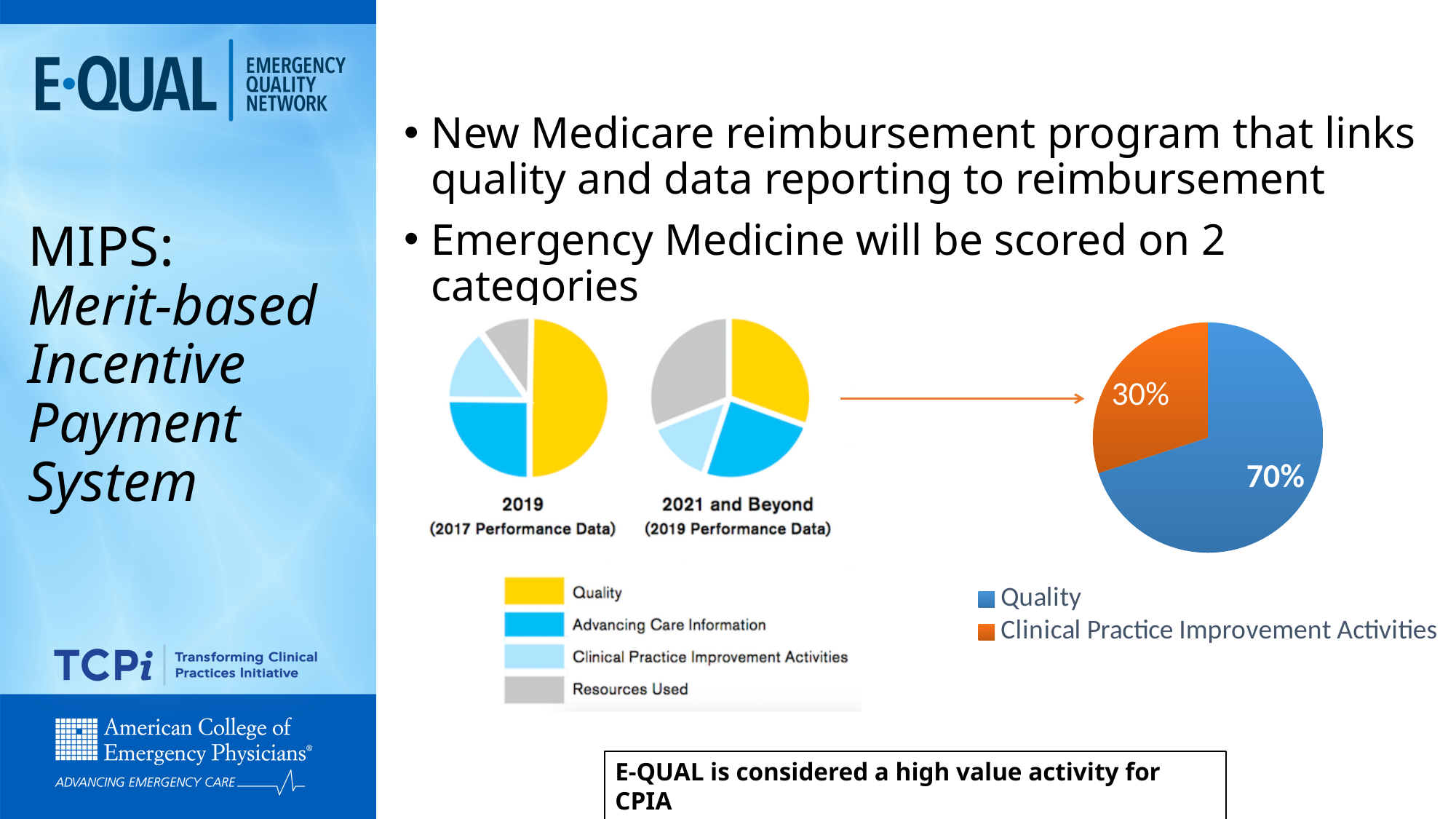
In the 2019 (2017 Performance Data) pie chart, which category has the largest slice? Quality In the pie chart on the right of the slide, which category has the larger share? Quality What kind of chart is shown on the right of the slide with the 70% and 30% labels? Pie chart How many categories does the legend of the pie chart on the right of the slide list? 2 In the pie chart on the right of the slide, what share is labelled for Quality? 70% How many categories does the legend for the 2019 and 2021 and Beyond pie charts list? 4 In the pie chart on the right of the slide, which category has the smaller share? Clinical Practice Improvement Activities In the pie chart on the right of the slide, what colour is the Quality slice? Blue How many pie charts are shown on the slide in total? 3 In the pie chart on the right of the slide, what is the difference in percentage points between the Quality share and the Clinical Practice Improvement Activities share? 40 percentage points In the legend for the 2019 and 2021 and Beyond pie charts, which category is shown in grey? Resources Used In the pie chart on the right of the slide, what share is labelled for Clinical Practice Improvement Activities? 30%